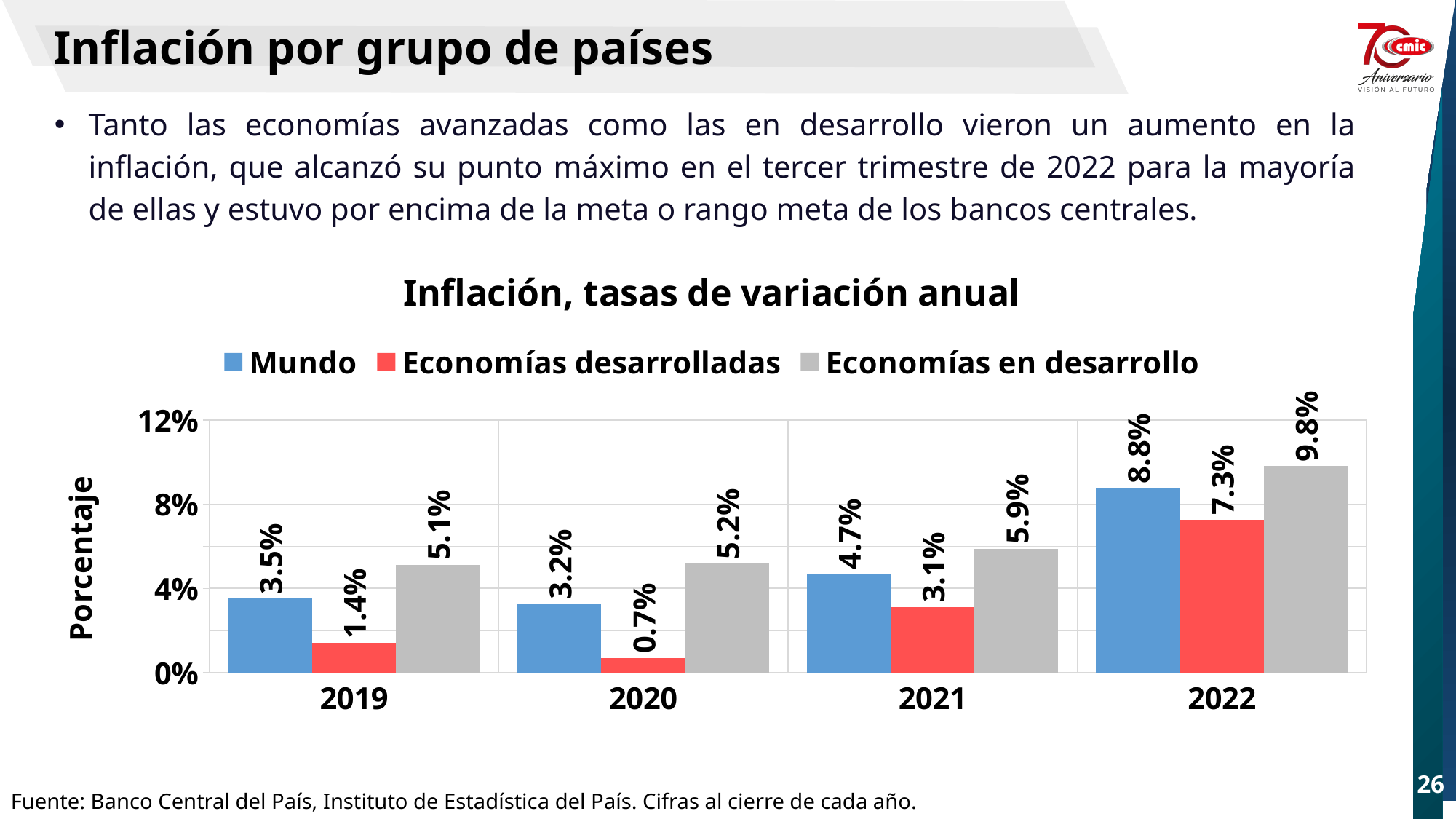
What is the difference between the Economías en desarrollo and Economías desarrolladas inflation rates in 2022? 2.5% What is the title of the chart? Inflación, tasas de variación anual How many series does the legend list? 3 In which year is the Economías desarrolladas inflation rate lowest? 2020 What kind of chart is shown? bar chart Which is larger in 2021: the Mundo inflation rate or the Economías desarrolladas inflation rate? Mundo What is the inflation rate for Mundo in 2022? 8.8% In which year is the Mundo inflation rate highest? 2022 What is the inflation rate for Economías desarrolladas in 2020? 0.7% What is the inflation rate for Economías en desarrollo in 2019? 5.1% How many years are shown on the x axis? 4 Is the value for Economías en desarrollo in 2022 greater or less than 8%? greater